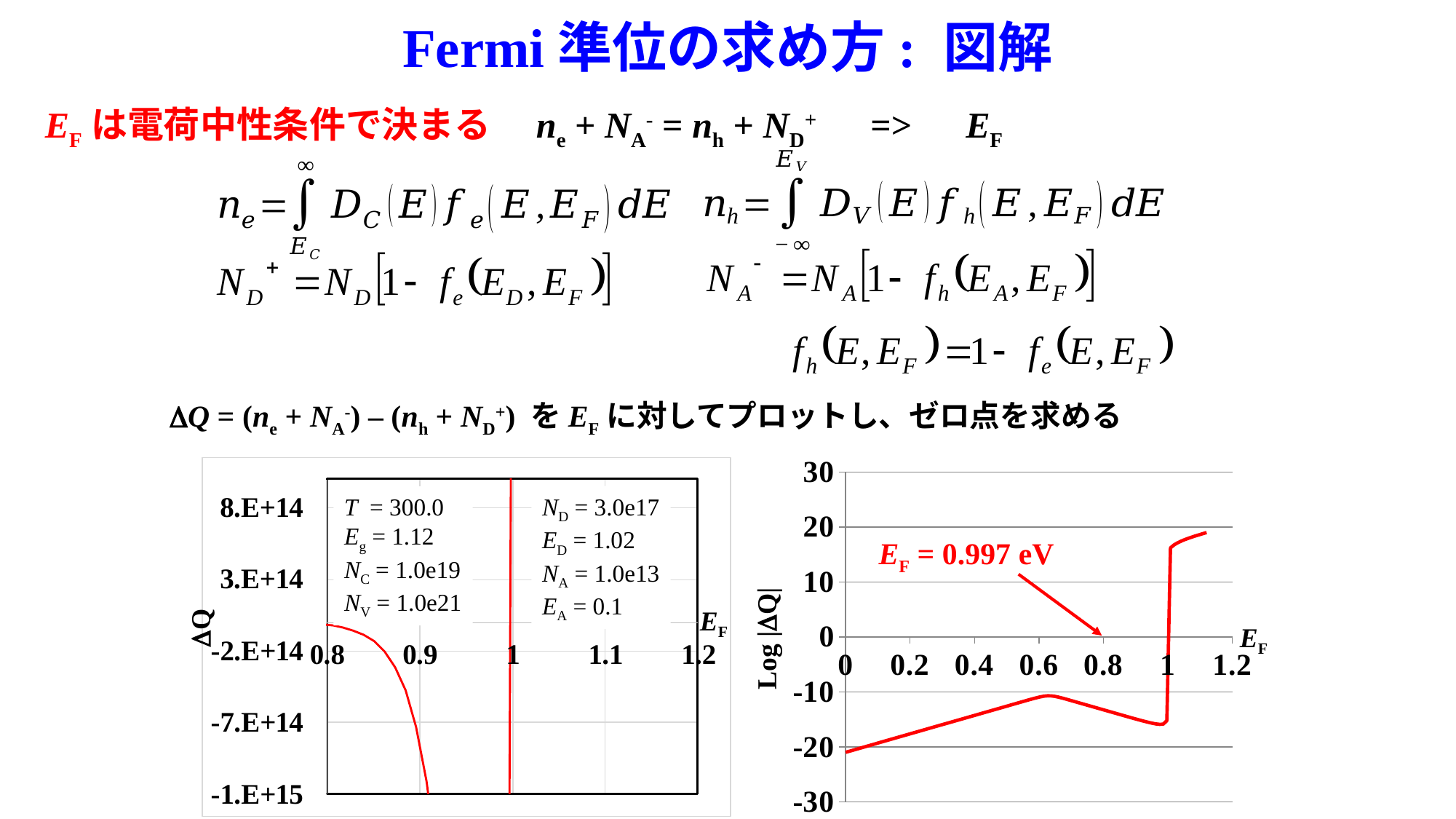
On the left chart, is the value of ΔQ at E_F = 0.85 greater or less than -7.E+14? greater On the right chart, is the value of Log |ΔQ| at E_F = 0.6 greater or less than -20? greater On the left chart, does ΔQ rise or fall as E_F goes from 0.8 to 0.9? fall On the right chart, does the curve rise or fall as E_F goes from 0.6 to just below 1? fall On the right chart, is the value of Log |ΔQ| at E_F = 0.2 greater or less than 0? less What is the label on the vertical axis of the right chart? Log |ΔQ| On the right chart, what value of E_F is indicated by the red annotation with the arrow? E_F = 0.997 eV What kind of chart is the right chart (Log |ΔQ| versus E_F)? line chart On the left chart, what temperature T is listed in the parameter box? 300.0 On the right chart, does the curve rise or fall as E_F goes from 0 to 0.6? rise What kind of chart is the left chart (ΔQ versus E_F)? line chart